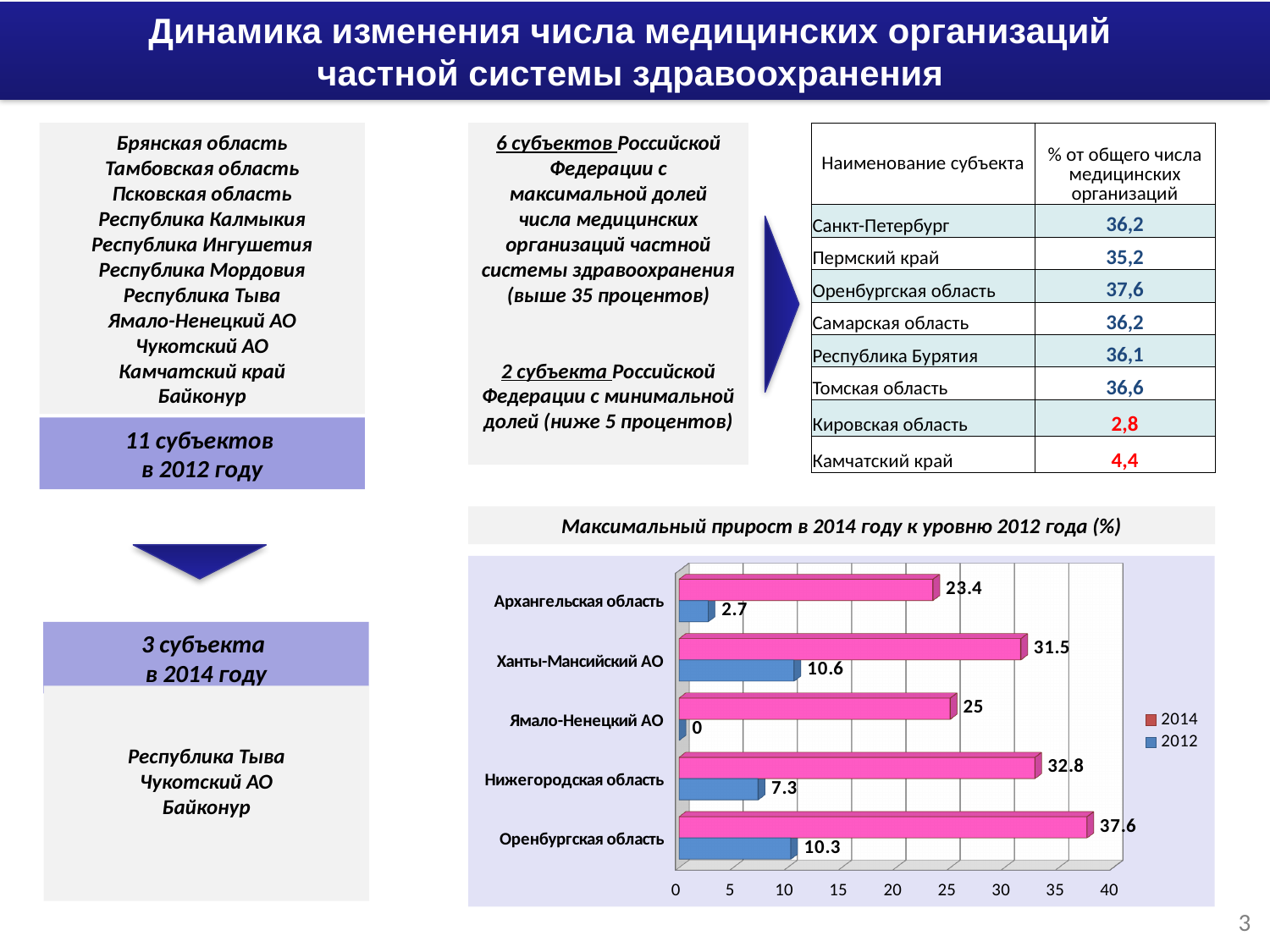
What is the 2012 value for Ханты-Мансийский АО in the chart? 10.6 Is the 2012 value for Архангельская область greater or less than 5? less How many regions (categories) are plotted in the chart? 5 What is the 2014 value for Оренбургская область in the chart? 37.6 What type of chart is shown on the slide? bar chart Which region has the highest 2014 value in the chart? Оренбургская область How many series does the chart legend list? 2 What is the title of the chart? Максимальный прирост в 2014 году к уровню 2012 года (%) What is the 2012 value for Ямало-Ненецкий АО in the chart? 0 Which is larger: the 2014 value for Ханты-Мансийский АО or the 2014 value for Ямало-Ненецкий АО? Ханты-Мансийский АО Which region has the lowest 2014 value in the chart? Архангельская область What is the difference between the 2014 and 2012 values for Нижегородская область? 25.5